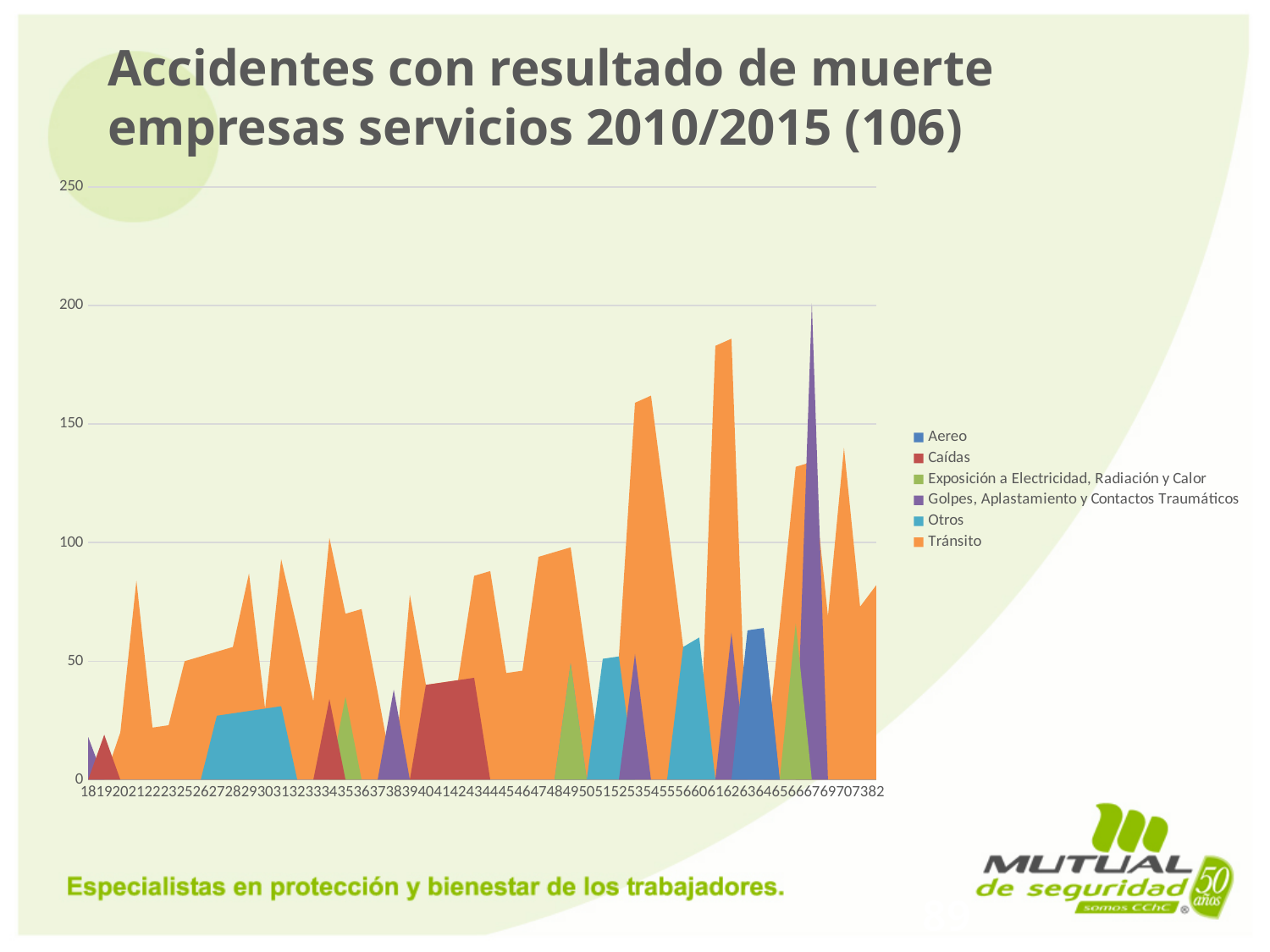
Is the highest peak of the Golpes, Aplastamiento y Contactos Traumáticos series greater or less than 150? greater Is the highest peak of the Exposición a Electricidad, Radiación y Calor series greater or less than 100? less Is the highest peak of the Caídas series greater or less than 50? less What type of chart is shown on the slide? Area chart How many series does the chart legend list? 6 Which colour represents the Tránsito series in the chart? Orange What is the title of the chart on the slide? Accidentes con resultado de muerte empresas servicios 2010/2015 (106) What is the maximum value shown on the vertical axis of the chart? 250 Which series reaches the highest value on the chart? Golpes, Aplastamiento y Contactos Traumáticos